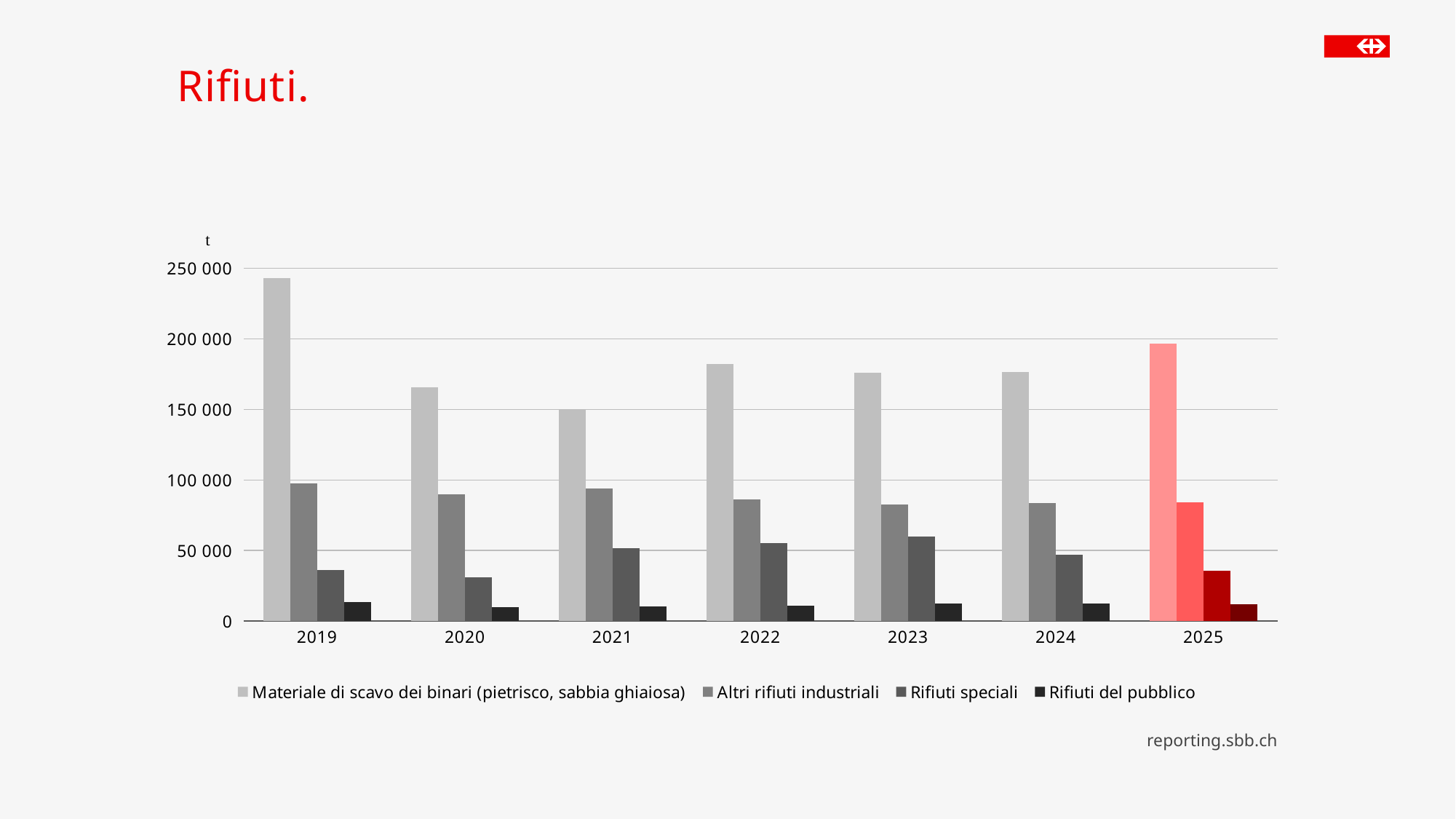
How many years are shown on the x axis? 7 Is the value for Rifiuti del pubblico in 2019 greater or less than 50 000? less What unit is shown on the y axis? t Is the value for Materiale di scavo dei binari in 2025 greater or less than 150 000? greater Is the value for Altri rifiuti industriali in 2022 greater or less than 100 000? less In which year is the value for Materiale di scavo dei binari (pietrisco, sabbia ghiaiosa) lowest? 2021 In which year is the value for Materiale di scavo dei binari (pietrisco, sabbia ghiaiosa) highest? 2019 Which is larger, the value for Materiale di scavo dei binari in 2021 or in 2022? 2022 What kind of chart is shown on the slide? Bar chart Which is larger, the value for Rifiuti speciali in 2020 or in 2021? 2021 How many series does the legend list? 4